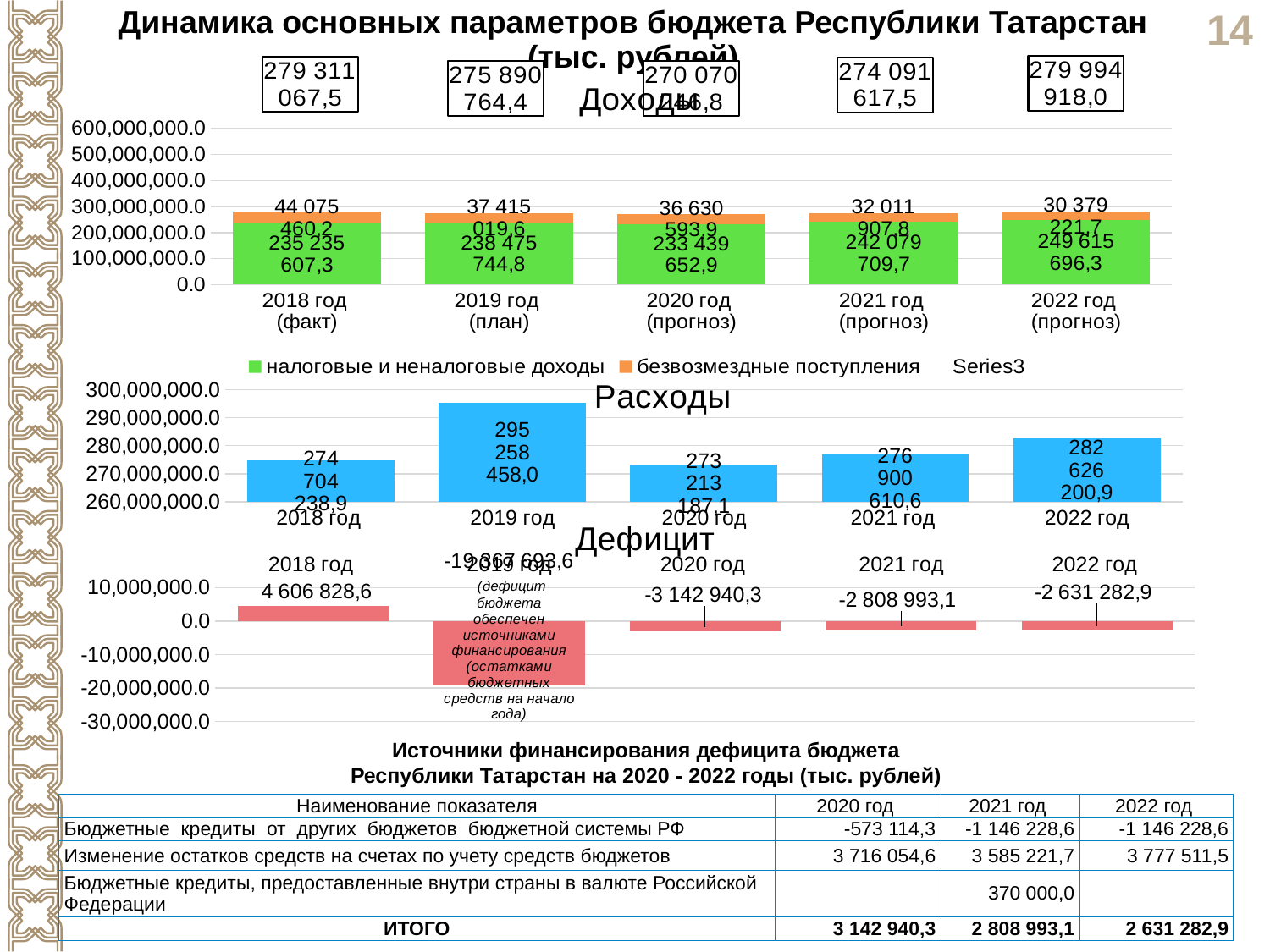
In the Расходы chart, what is the difference between the values for 2022 год and 2018 год? 7 921 962,0 In the Расходы chart, which year has the lowest value? 2020 год In the Доходы chart, what is the total of the stacked bar for 2019 год (план)? 275 890 764,4 In the Доходы chart, which year has the highest безвозмездные поступления? 2018 год (факт) What kind of chart is the Доходы chart? bar chart In the Доходы chart, what is the value of налоговые и неналоговые доходы for 2022 год (прогноз)? 249 615 696,3 In the Дефицит chart, what is the value for 2020 год? -3 142 940,3 In the Расходы chart, what is the value for 2021 год? 276 900 610,6 In the Доходы chart, what is the value of безвозмездные поступления for 2018 год (факт)? 44 075 460,2 In the Доходы chart, do the безвозмездные поступления values rise or fall from 2018 to 2022? fall In the Расходы chart, which year has the highest value? 2019 год How many entries does the legend of the Доходы chart list? 3